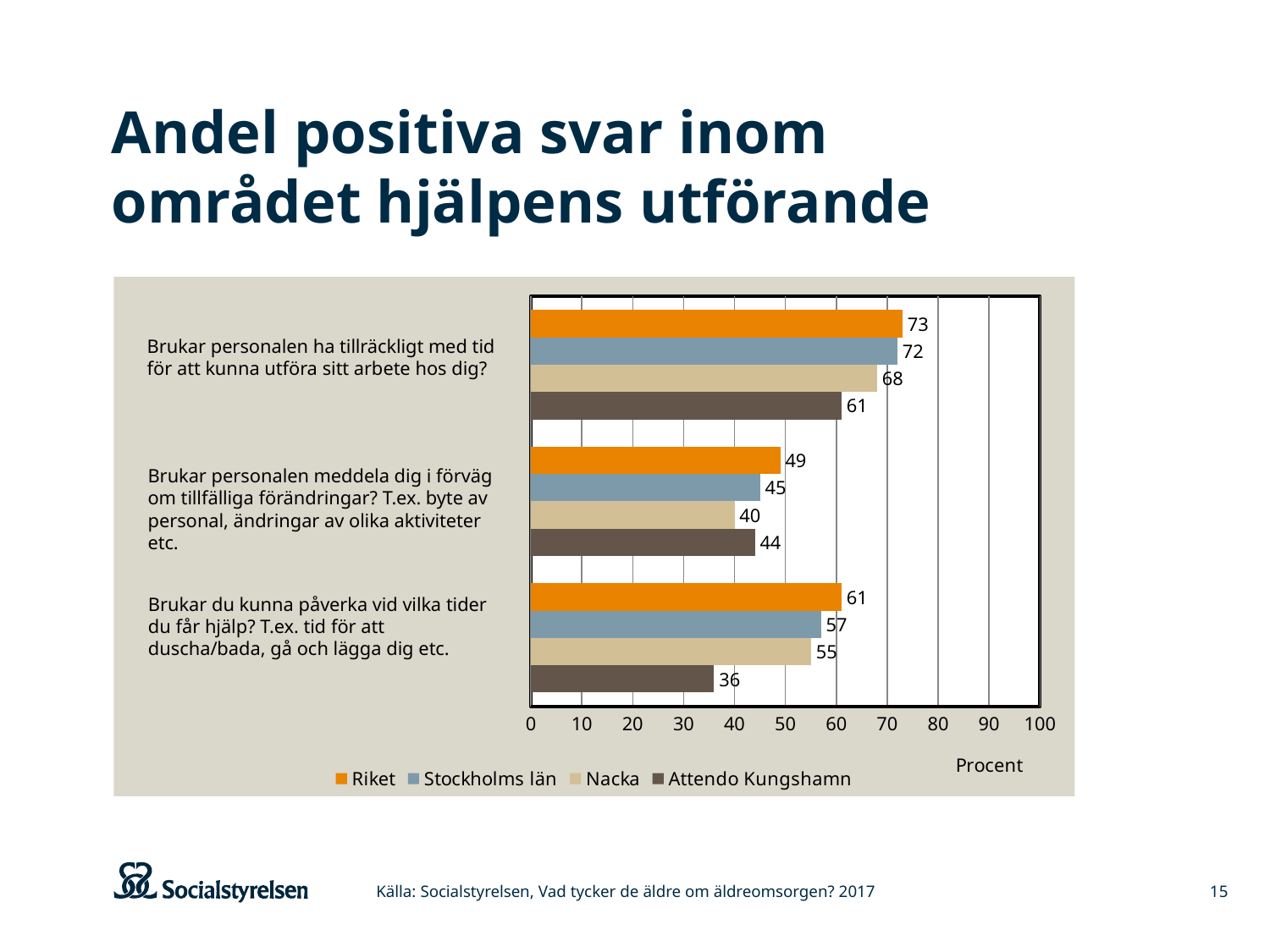
How many questions (categories) are shown in the chart? 3 What is the value for Nacka on the question "Brukar personalen meddela dig i förväg om tillfälliga förändringar?"? 40 Is the value for Stockholms län on the question "Brukar personalen ha tillräckligt med tid för att kunna utföra sitt arbete hos dig?" greater or less than 60? greater Which series has the highest value on the question "Brukar personalen ha tillräckligt med tid för att kunna utföra sitt arbete hos dig?"? Riket What unit is shown on the horizontal axis of the chart? Procent What is the value for Attendo Kungshamn on the question "Brukar du kunna påverka vid vilka tider du får hjälp?"? 36 Which series has the lowest value on the question "Brukar du kunna påverka vid vilka tider du får hjälp?"? Attendo Kungshamn What is the difference between Riket and Attendo Kungshamn on the question "Brukar du kunna påverka vid vilka tider du får hjälp?"? 25 How many series does the legend list? 4 Which is larger on the question "Brukar personalen meddela dig i förväg om tillfälliga förändringar?": Nacka or Attendo Kungshamn? Attendo Kungshamn What kind of chart is shown on the slide? Bar chart What is the value for Riket on the question "Brukar personalen ha tillräckligt med tid för att kunna utföra sitt arbete hos dig?"? 73